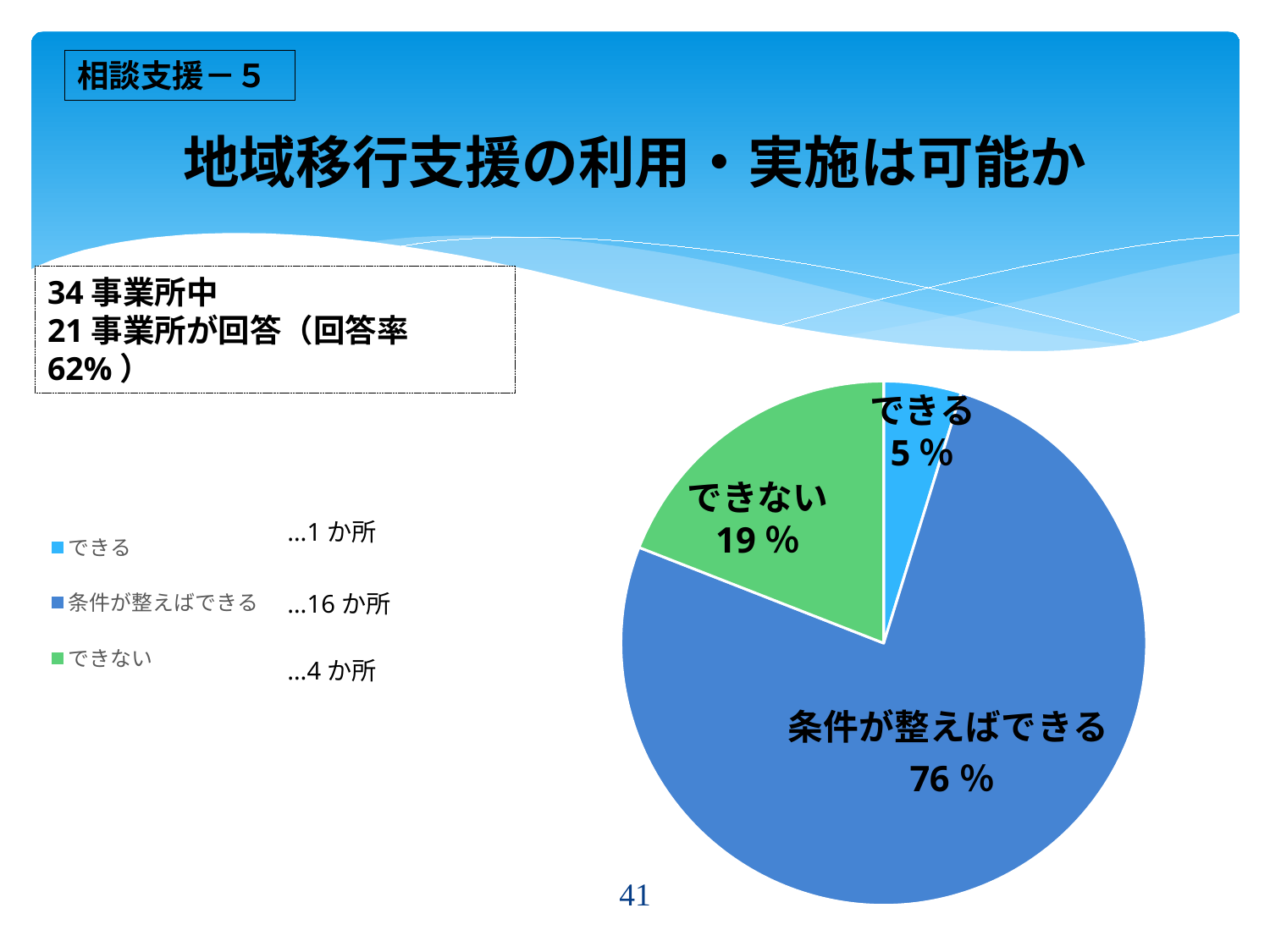
Which is larger, the slice for できない or the slice for できる? できない What share of the pie does 条件が整えばできる represent? 76 % What colour is the できない slice in the pie chart? green What share of the pie does できない represent? 19 % What is the difference in percentage points between the 条件が整えばできる slice and the できない slice? 57 How many 事業所 answered 条件が整えばできる according to the text next to the legend? 16 か所 How many entries does the legend list? 3 What share of the pie does できる represent? 5 % What kind of chart is shown on the slide? pie chart How many slices does the pie chart have? 3 Which category has the largest slice of the pie? 条件が整えばできる Which category has the smallest slice of the pie? できる